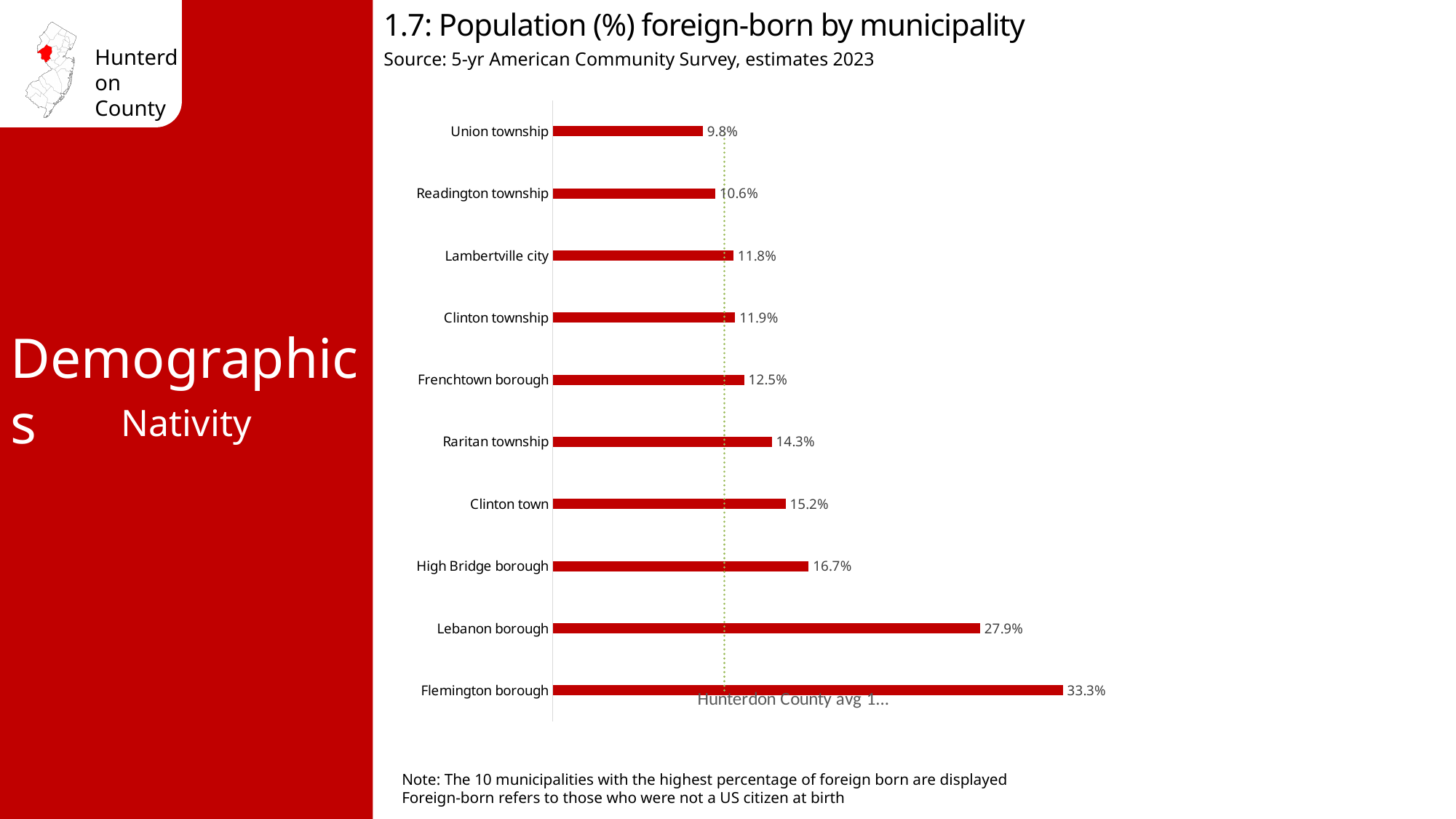
What is the percentage of foreign-born population in High Bridge borough? 16.7% What is the difference in percentage points between Flemington borough and Lebanon borough? 5.4 Which has a higher foreign-born percentage, Frenchtown borough or Clinton township? Frenchtown borough Which municipality has the highest percentage of foreign-born population? Flemington borough Which municipality has the lowest percentage of foreign-born population shown on the chart? Union township How many municipalities are shown on the chart? 10 What kind of chart is used to show the foreign-born population by municipality? Bar chart What is the source of the data shown in the chart? 5-yr American Community Survey, estimates 2023 What is the percentage of foreign-born population in Readington township? 10.6% What is the title of the chart? 1.7: Population (%) foreign-born by municipality What is the difference in percentage points between Clinton town and Raritan township? 0.9 What is the percentage of foreign-born population in Flemington borough? 33.3%